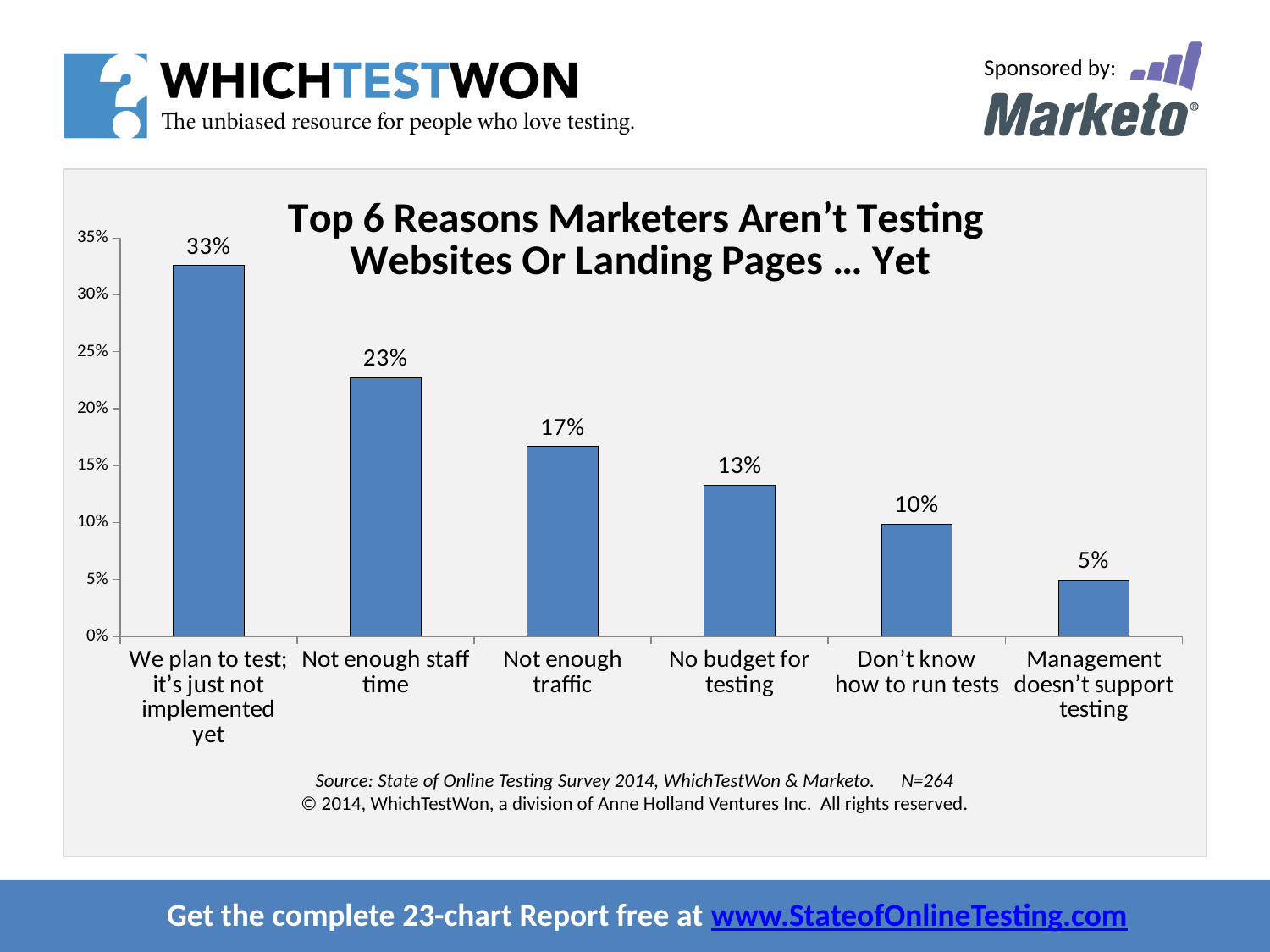
Is the value for "Not enough staff time" greater or less than 20%? greater What percentage is shown for "Don't know how to run tests"? 10% What is the value for "No budget for testing"? 13% How many reasons are shown in the chart? 6 What percentage of marketers cite "Not enough staff time" as a reason for not testing? 23% What is the title of the chart? Top 6 Reasons Marketers Aren't Testing Websites Or Landing Pages … Yet What is the difference between "We plan to test; it's just not implemented yet" and "Not enough traffic"? 16% Which is larger: "Not enough traffic" or "No budget for testing"? Not enough traffic Which reason has the highest percentage? We plan to test; it's just not implemented yet Do the values rise or fall from left to right across the chart? Fall Which reason has the lowest percentage? Management doesn't support testing What kind of chart is shown on the slide? Bar chart